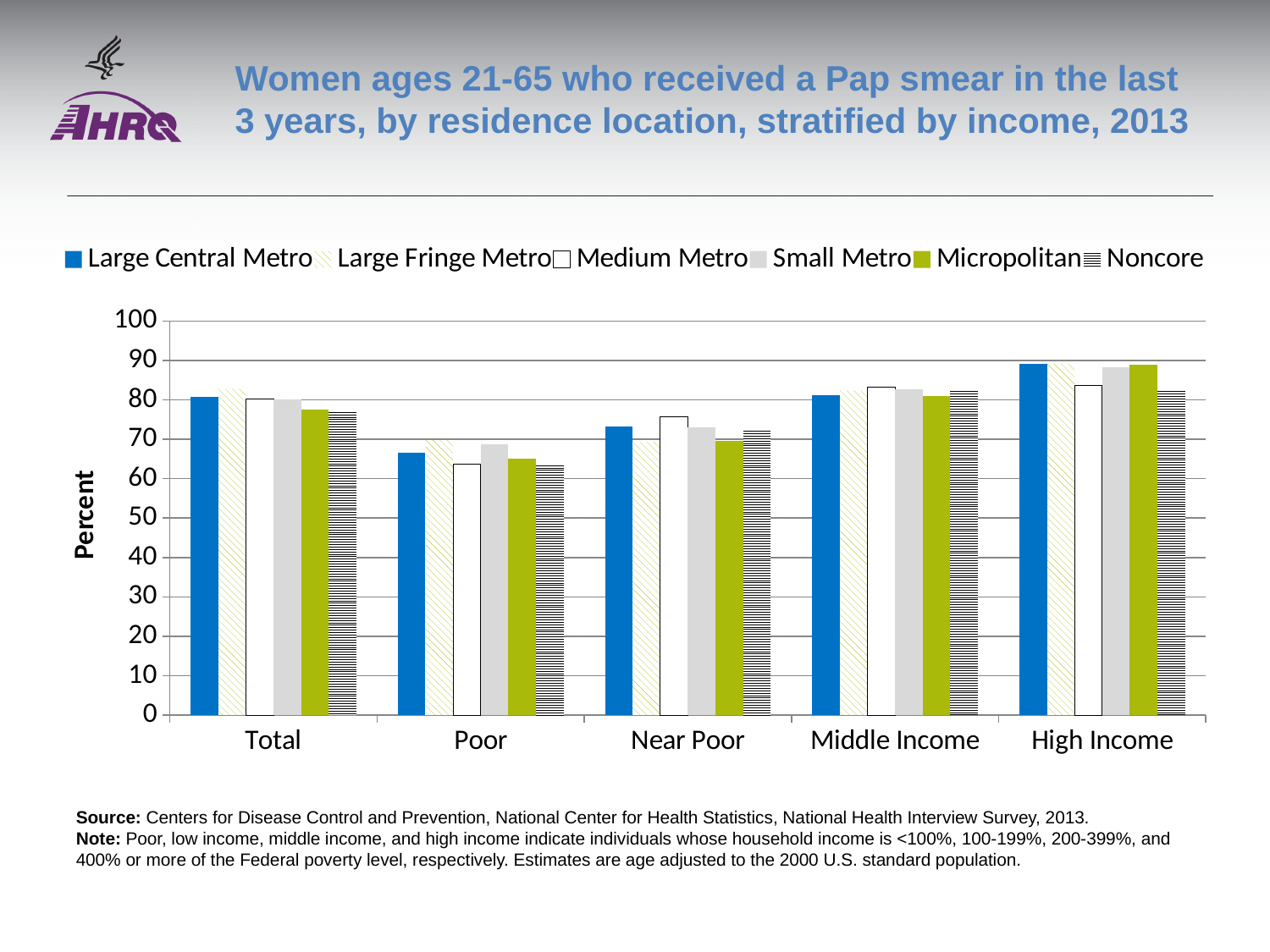
What is the label on the y axis? Percent How many income categories are shown along the x axis? 5 How many series does the legend list? 6 What kind of chart is shown on the slide? bar chart For Medium Metro, which is larger: the Poor value or the Middle Income value? Middle Income Is the value for Large Central Metro in the Poor group greater or less than 70? less Which income group has the lowest Large Central Metro value? Poor For Large Central Metro, which is larger: the Poor value or the High Income value? High Income Which income group has the highest Large Central Metro value? High Income Is the value for Large Central Metro in the High Income group greater or less than 80? greater Is the value for Medium Metro in the Poor group greater or less than 70? less